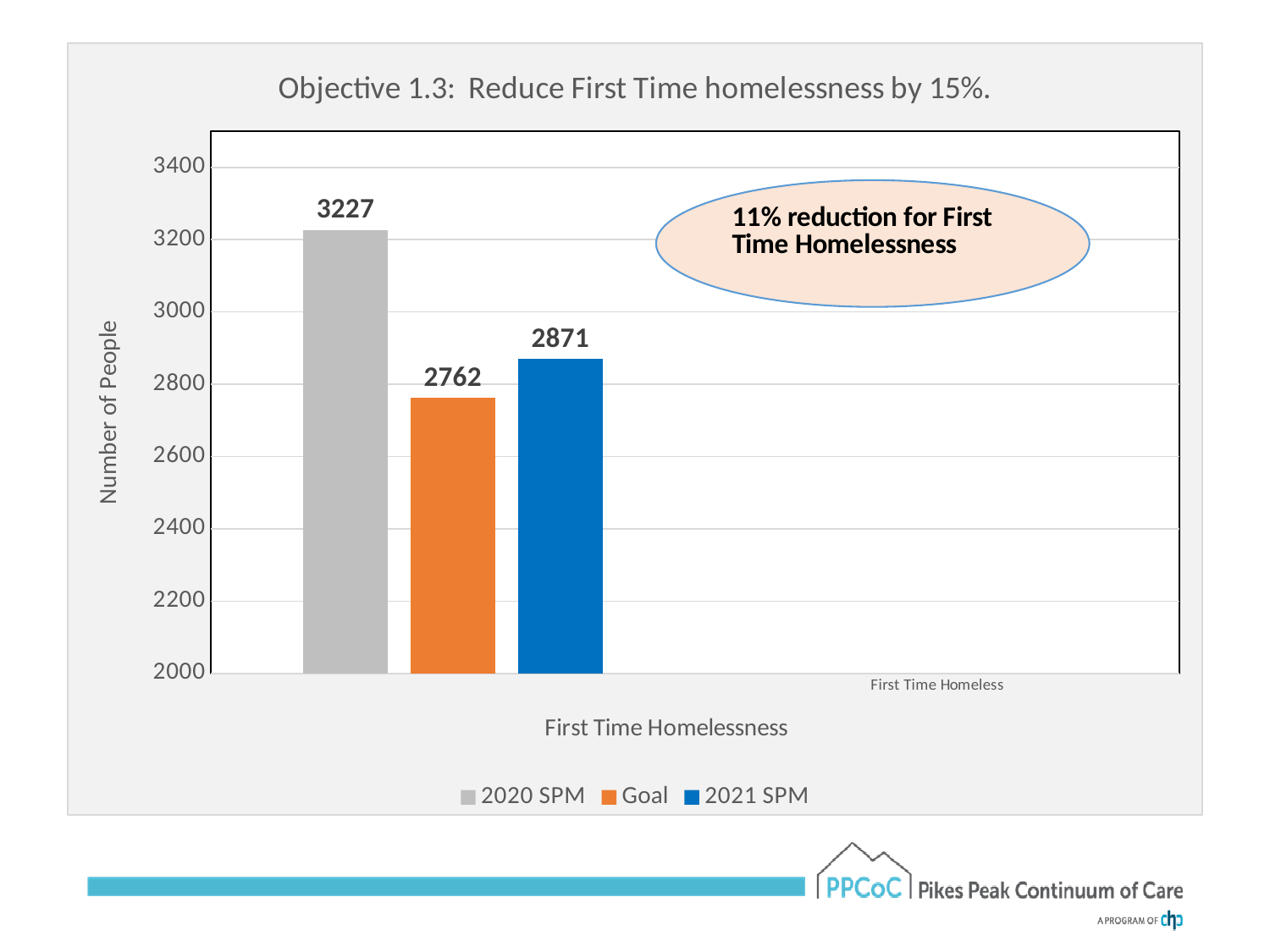
What is the value for 2020 SPM? 3227 What is the value for 2021 SPM? 2871 Is the value for 2020 SPM greater or less than 3000? greater Which series has the highest value? 2020 SPM Which is larger, the Goal value or the 2021 SPM value? 2021 SPM What is the difference between the 2021 SPM value and the Goal value? 109 What is the title of the chart? Objective 1.3: Reduce First Time homelessness by 15%. What is the value for Goal? 2762 Which series has the lowest value? Goal How many series does the legend list? 3 What kind of chart is shown? bar chart What is the difference between the 2020 SPM value and the 2021 SPM value? 356